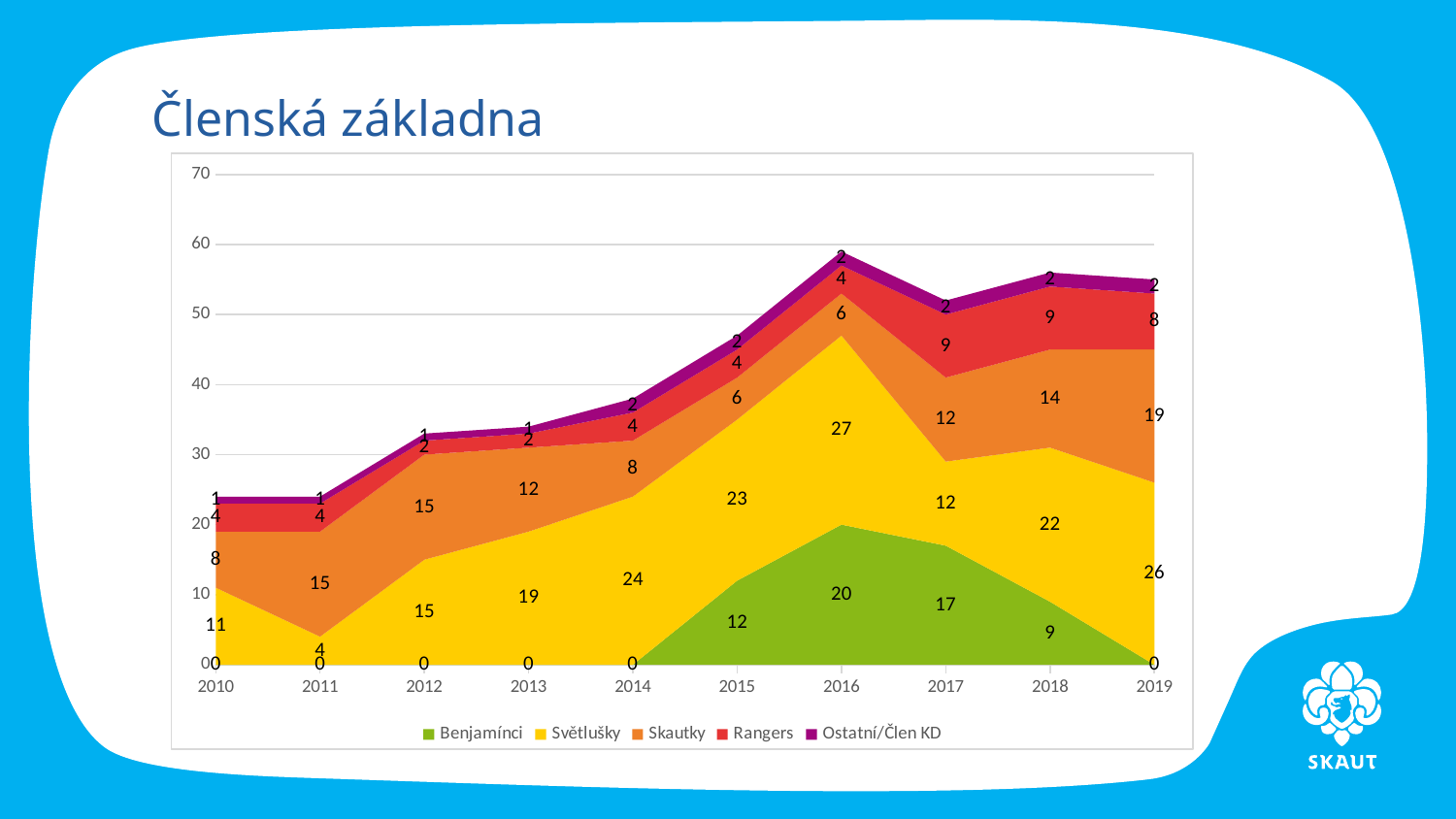
What is the value for Světlušky in 2016? 27 How many series does the legend list? 5 What is the title of the chart? Členská základna What is the difference between the Skautky values in 2019 and 2015? 13 What is the value for Skautky in 2019? 19 In which year is the Světlušky value lowest? 2011 In which year is the Benjamínci value highest? 2016 What is the value for Benjamínci in 2017? 17 Which is larger in 2018: Světlušky or Skautky? Světlušky What is the total of all series in 2016? 59 How many years are shown on the x axis? 10 What kind of chart is shown on the slide? Stacked area chart